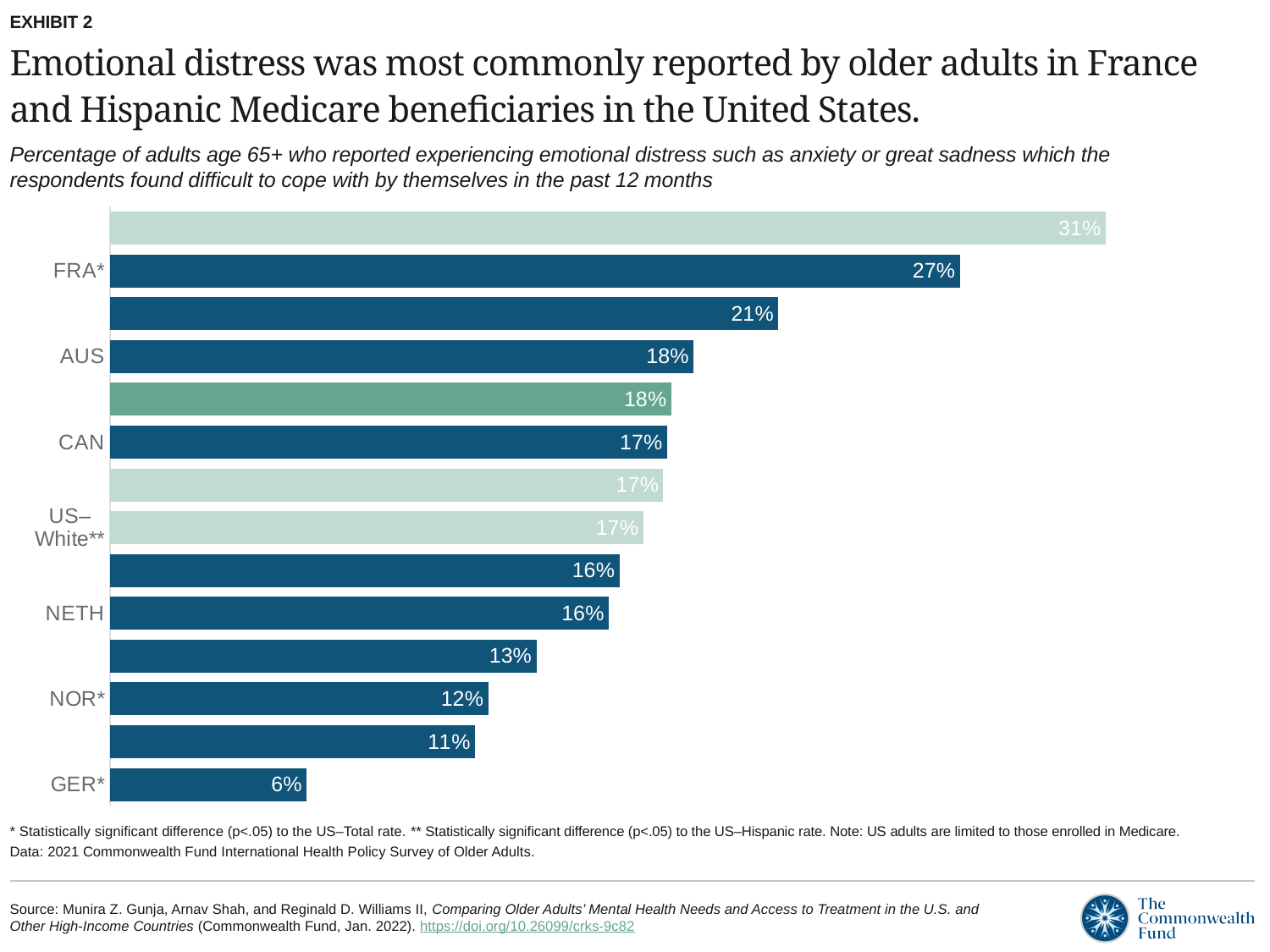
What is the value for US–White**? 17% What kind of chart is shown on the slide? Bar chart What percentage is shown for FRA*? 27% What is the difference in percentage points between FRA* and GER*? 21 percentage points What percentage is shown for NETH? 16% What is the highest value shown on the chart? 31% What is the value for AUS? 18% What percentage is reported for CAN? 17% What is the value for NOR*? 12% What percentage is shown for GER*? 6% Which labelled country has the lowest percentage? GER* Which has the larger value, AUS or NETH? AUS